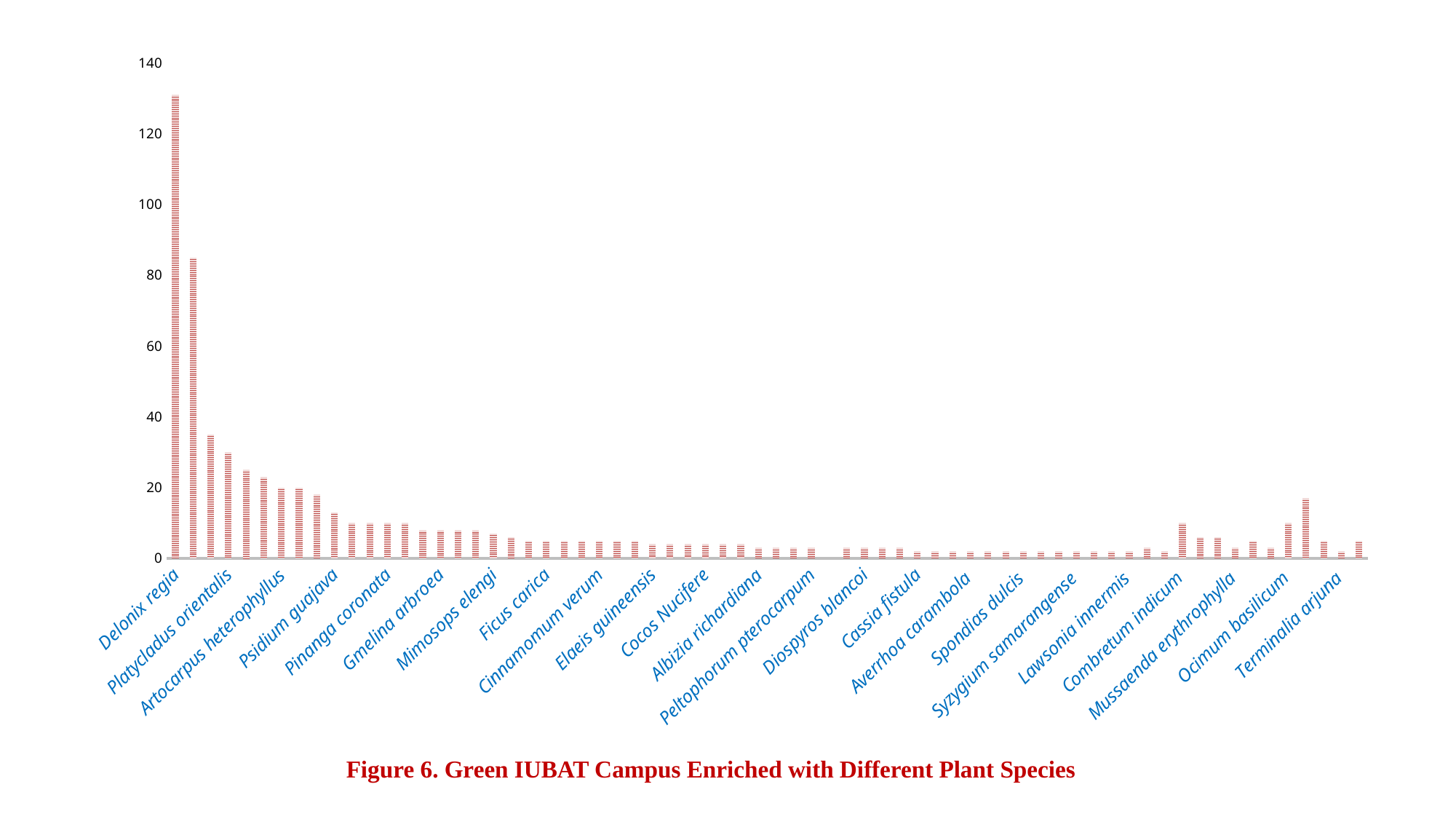
What is the caption of the figure shown on the slide? Figure 6. Green IUBAT Campus Enriched with Different Plant Species Is the value for Artocarpus heterophyllus greater or less than 40? less Which plant species has the highest value in the chart? Delonix regia Is the value for Psidium guajava greater or less than 20? less Is the value for Platycladus orientalis greater or less than 40? less Which is larger, the value for Delonix regia or the value for Platycladus orientalis? Delonix regia Do the bar values generally rise or fall from left to right across the chart? fall Which is larger, the value for Platycladus orientalis or the value for Cassia fistula? Platycladus orientalis What kind of chart is shown on the slide? bar chart What colour are the bars in the chart? red